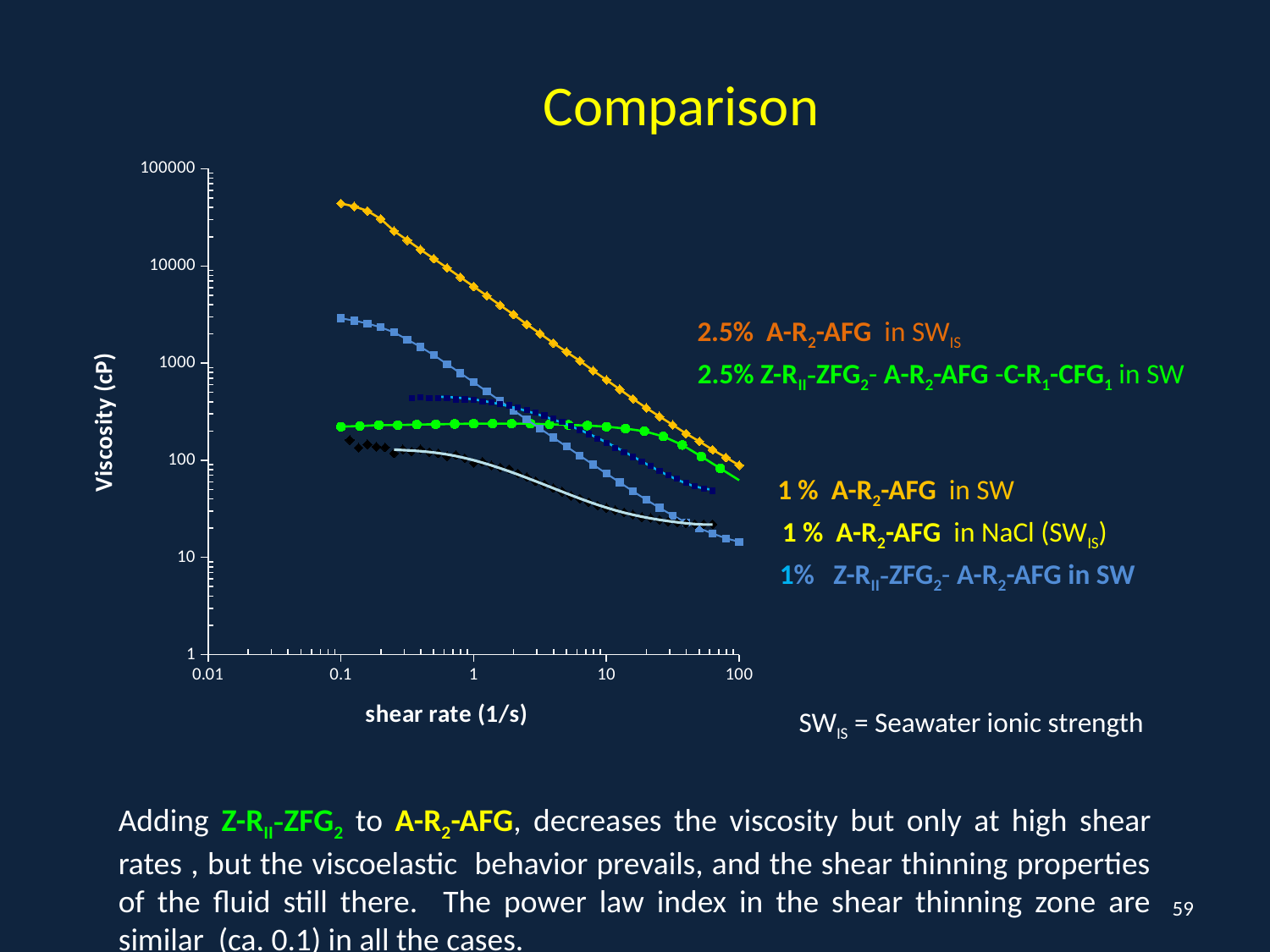
Does the viscosity of the 2.5% A-R2-AFG in SWIS curve rise or fall as shear rate increases? Fall At a shear rate of 0.1, which has the higher viscosity: 2.5% A-R2-AFG in SWIS or 1% Z-RII-ZFG2-A-R2-AFG in SW? 2.5% A-R2-AFG in SWIS Is the viscosity of the 2.5% A-R2-AFG in SWIS curve at a shear rate of 0.1 greater or less than 10000? greater Is the viscosity of the 2.5% Z-RII-ZFG2-A-R2-AFG-C-R1-CFG1 in SW curve at a shear rate of 1 greater or less than 1000? less What is the highest value shown on the y-axis of the chart? 100000 What is the label of the y-axis of the chart? Viscosity (cP) Is the viscosity of the 2.5% Z-RII-ZFG2-A-R2-AFG-C-R1-CFG1 in SW curve at a shear rate of 1 greater or less than 100? greater What is the label of the x-axis of the chart? shear rate (1/s) Which series reaches the highest viscosity on the chart? 2.5% A-R2-AFG in SWIS What type of chart is shown on the slide? Line chart (log-log scatter with lines) How many fluid series are labelled on the chart? 5